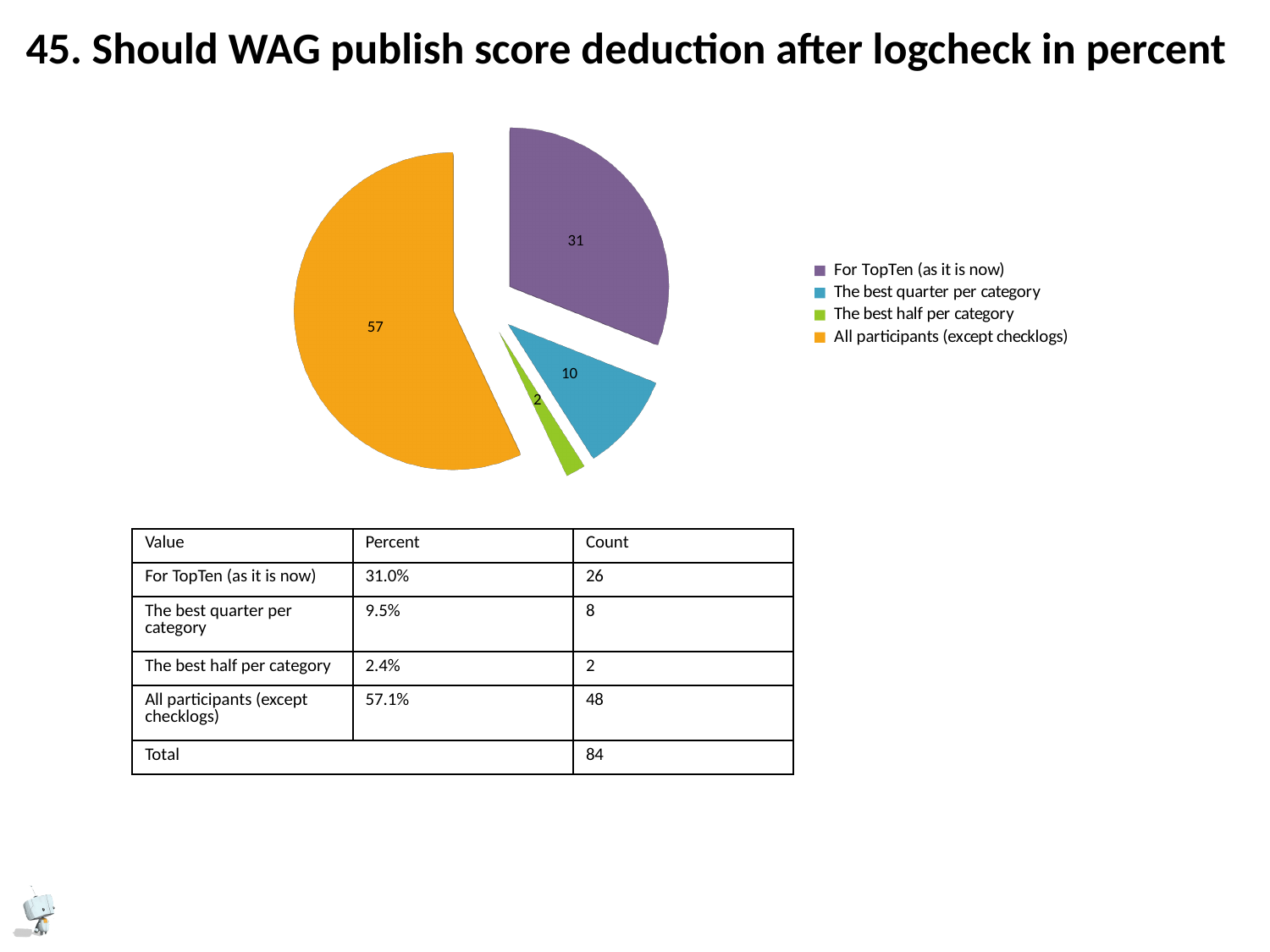
What colour is the slice for "All participants (except checklogs)"? Orange What is the difference between the labelled values for "All participants (except checklogs)" and "For TopTen (as it is now)"? 26 How many slices does the pie chart have? 4 How many entries does the legend list? 4 Which category has the largest slice of the pie? All participants (except checklogs) What value is labelled on the pie slice for "The best half per category"? 2 What value is labelled on the pie slice for "The best quarter per category"? 10 What value is labelled on the pie slice for "All participants (except checklogs)"? 57 What value is labelled on the pie slice for "For TopTen (as it is now)"? 31 What kind of chart is shown on the slide? Pie chart Which category has the smallest slice of the pie? The best half per category Which slice is larger: "The best quarter per category" or "The best half per category"? The best quarter per category